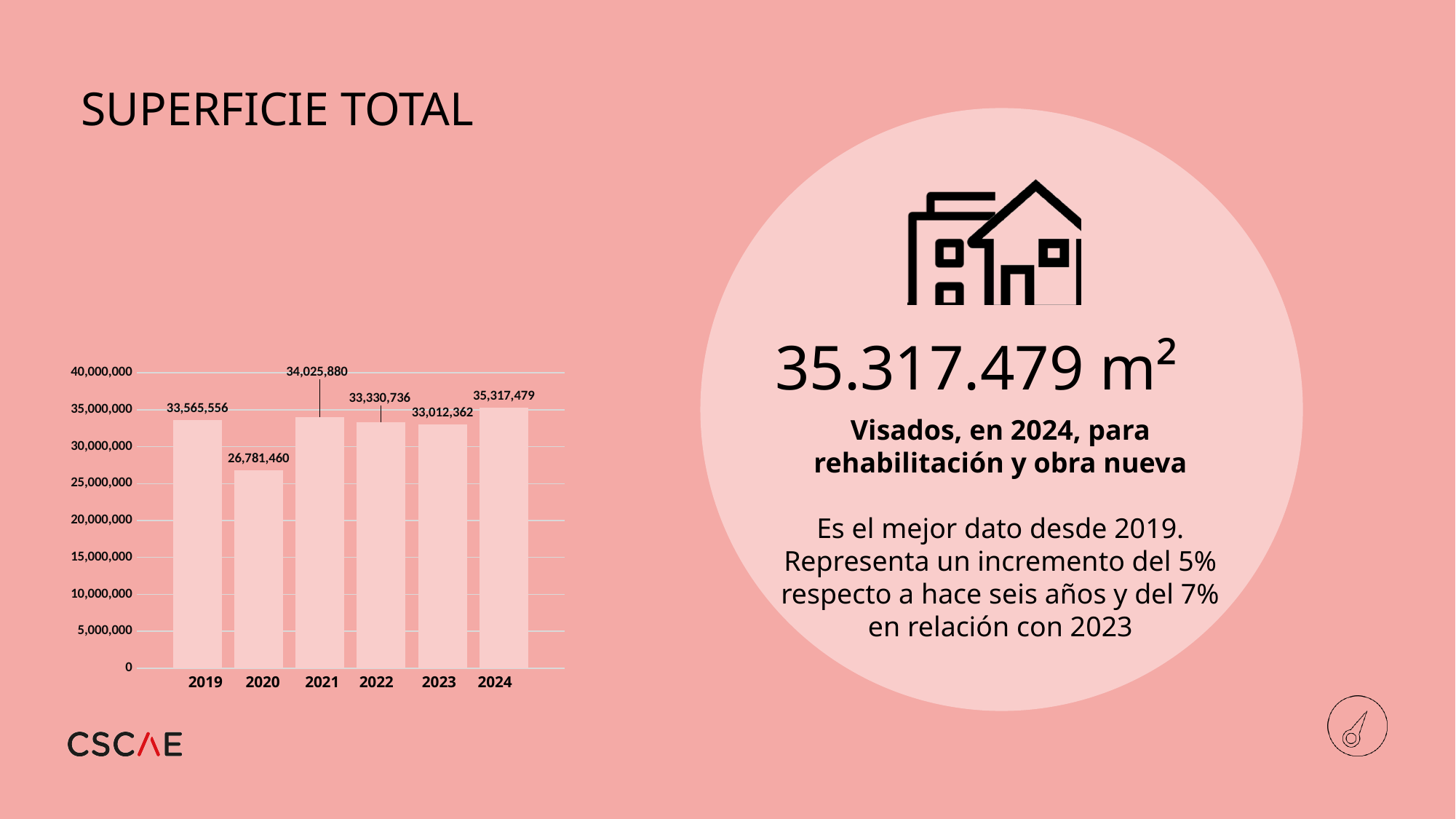
What is the difference between the values for 2021 and 2020? 7,244,420 How many years are shown on the x axis of the bar chart? 6 Which year has the lowest value in the bar chart? 2020 What is the difference between the values for 2024 and 2023? 2,305,117 What is the value for 2021 in the bar chart? 34,025,880 What kind of chart is shown on the slide? bar chart Is the value for 2020 greater or less than 30,000,000? less Which is larger, the value for 2022 or the value for 2023? 2022 What is the value for 2020 in the bar chart? 26,781,460 Which year has the highest value in the bar chart? 2024 What is the value for 2024 in the bar chart? 35,317,479 What is the title of the slide containing the chart? SUPERFICIE TOTAL